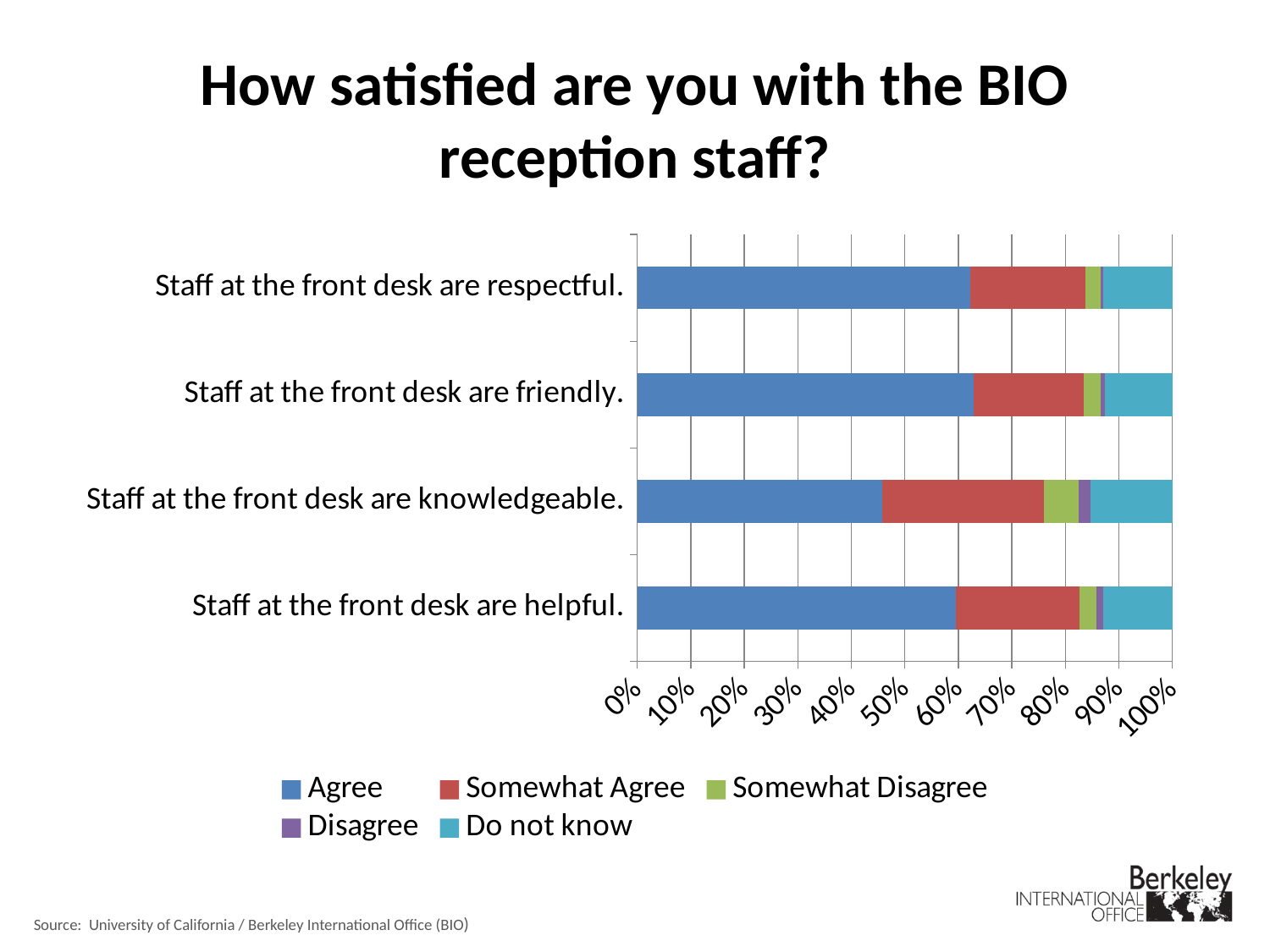
Which has a larger 'Somewhat Disagree' share: 'Staff at the front desk are knowledgeable.' or 'Staff at the front desk are respectful.'? Staff at the front desk are knowledgeable. Is the 'Agree' share for 'Staff at the front desk are helpful.' greater or less than 50%? greater What kind of chart is shown on the slide? Stacked bar chart Is the 'Agree' share for 'Staff at the front desk are knowledgeable.' greater or less than 50%? less What is the title of the slide? How satisfied are you with the BIO reception staff? Which statement has the largest 'Somewhat Agree' share? Staff at the front desk are knowledgeable. Which statement has the smallest 'Agree' share? Staff at the front desk are knowledgeable. How many statements (categories) are plotted on the chart? 4 Is the 'Agree' share for 'Staff at the front desk are respectful.' greater or less than 60%? greater Which series is shown in blue in the legend? Agree How many series does the legend list? 5 Which has a larger 'Agree' share: 'Staff at the front desk are friendly.' or 'Staff at the front desk are knowledgeable.'? Staff at the front desk are friendly.